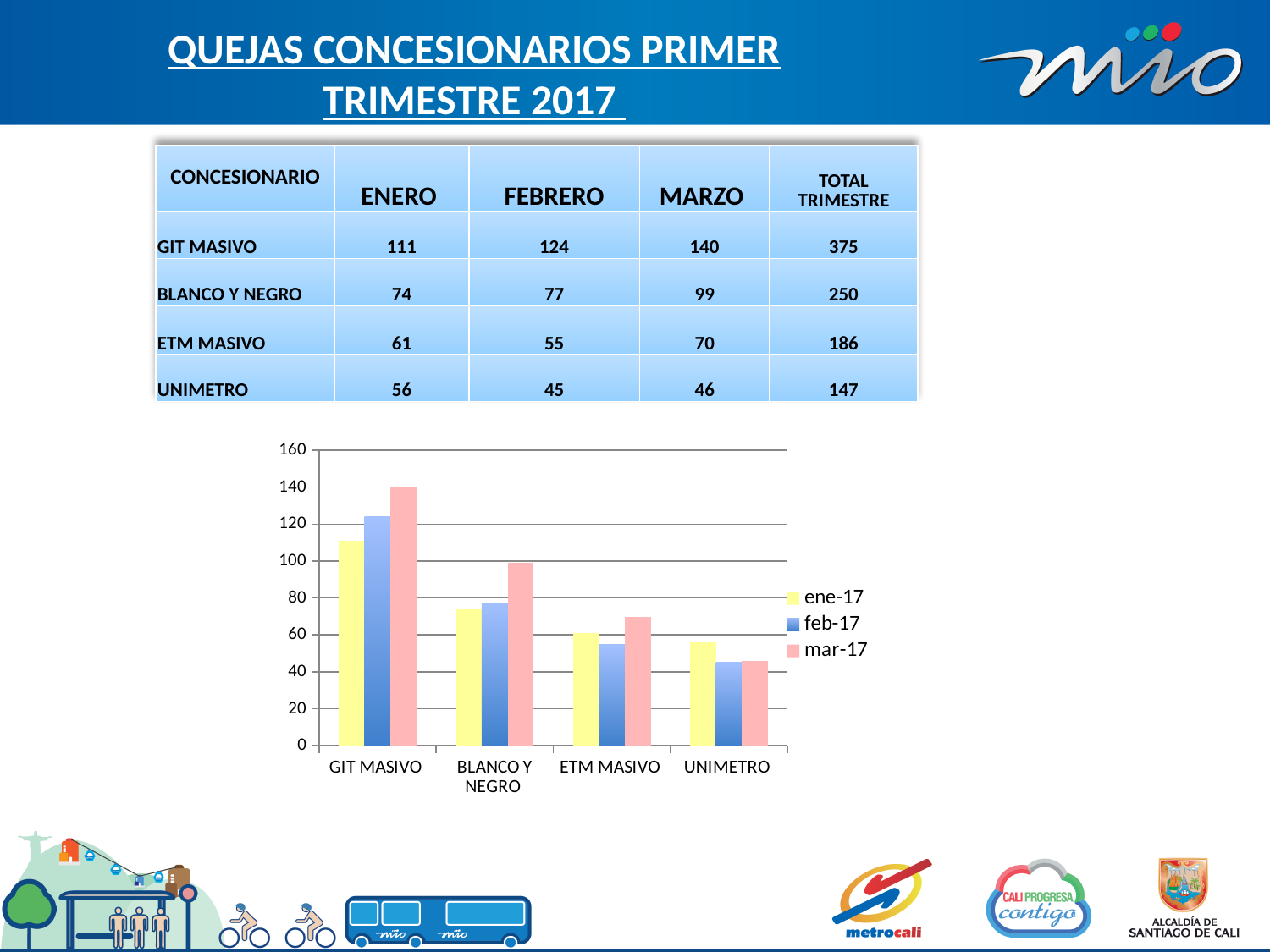
Which concesionario has the lowest feb-17 bar? UNIMETRO What is the ene-17 value for BLANCO Y NEGRO? 74 What is the difference between the mar-17 and ene-17 values for GIT MASIVO? 29 Is the feb-17 value for ETM MASIVO greater or less than 60? less Which is larger for UNIMETRO: the ene-17 bar or the mar-17 bar? ene-17 What is the mar-17 value for GIT MASIVO in the chart? 140 Is the mar-17 value for BLANCO Y NEGRO greater or less than 80? greater What kind of chart is shown on the slide? bar chart How many series does the chart legend list? 3 Which concesionario has the highest mar-17 bar? GIT MASIVO Do the values for GIT MASIVO rise or fall from ene-17 to mar-17? rise How many concesionarios (categories) are shown on the x axis of the chart? 4